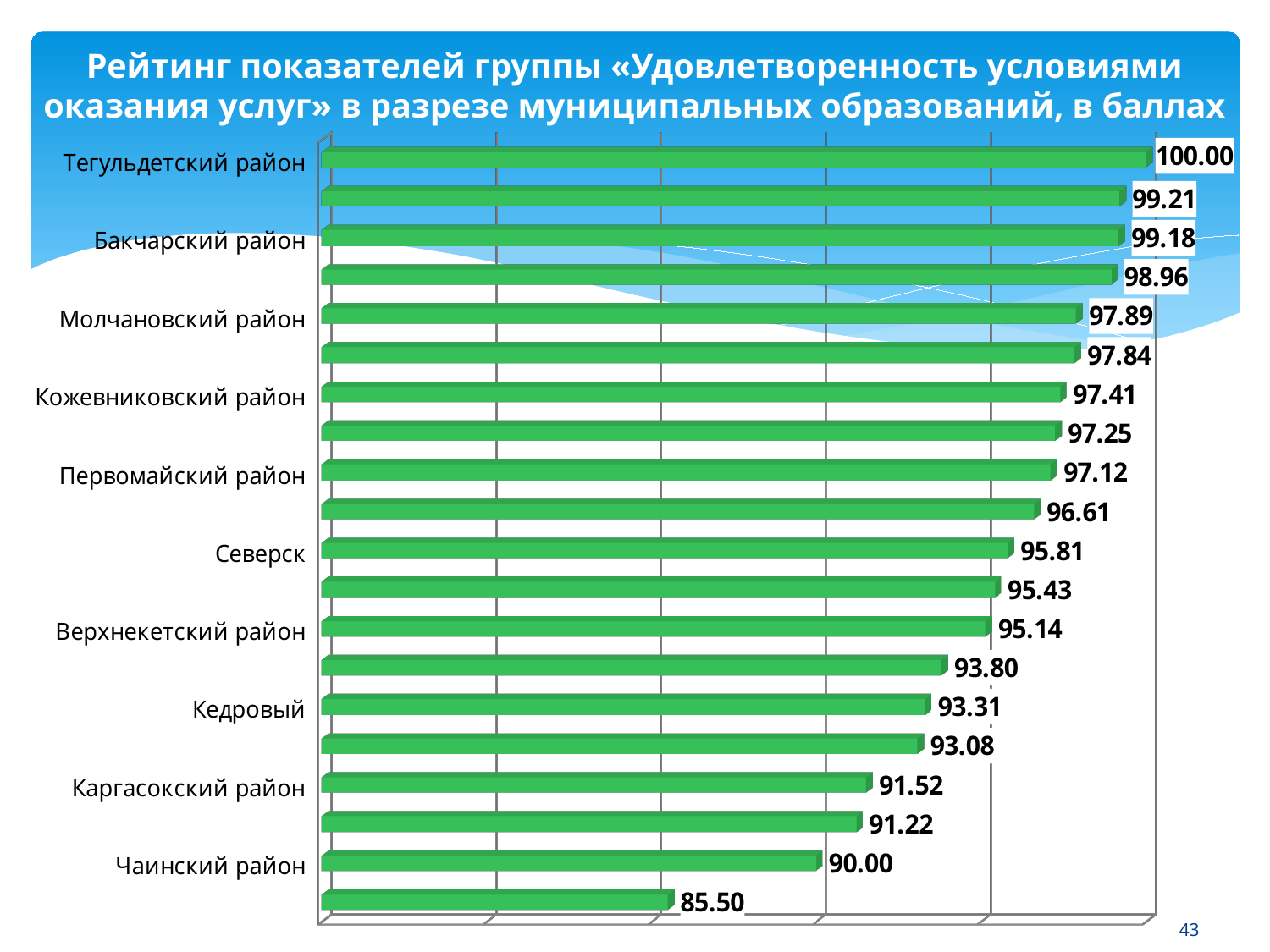
Which is larger, the value for Бакчарский район or the value for Молчановский район? Бакчарский район How many bars are plotted on the chart? 20 What is the difference between the values for Тегульдетский район and Чаинский район? 10.00 What is the difference between the values for Северск and Кедровый? 2.50 What is the value for Чаинский район? 90.00 What is the smallest value printed on the chart? 85.50 Which labelled municipality has the highest value? Тегульдетский район What is the value for Северск? 95.81 Do the bar values increase or decrease from the top of the chart to the bottom? Decrease What is the value for Кедровый? 93.31 What is the value for Тегульдетский район? 100.00 What kind of chart is shown on the slide? Bar chart